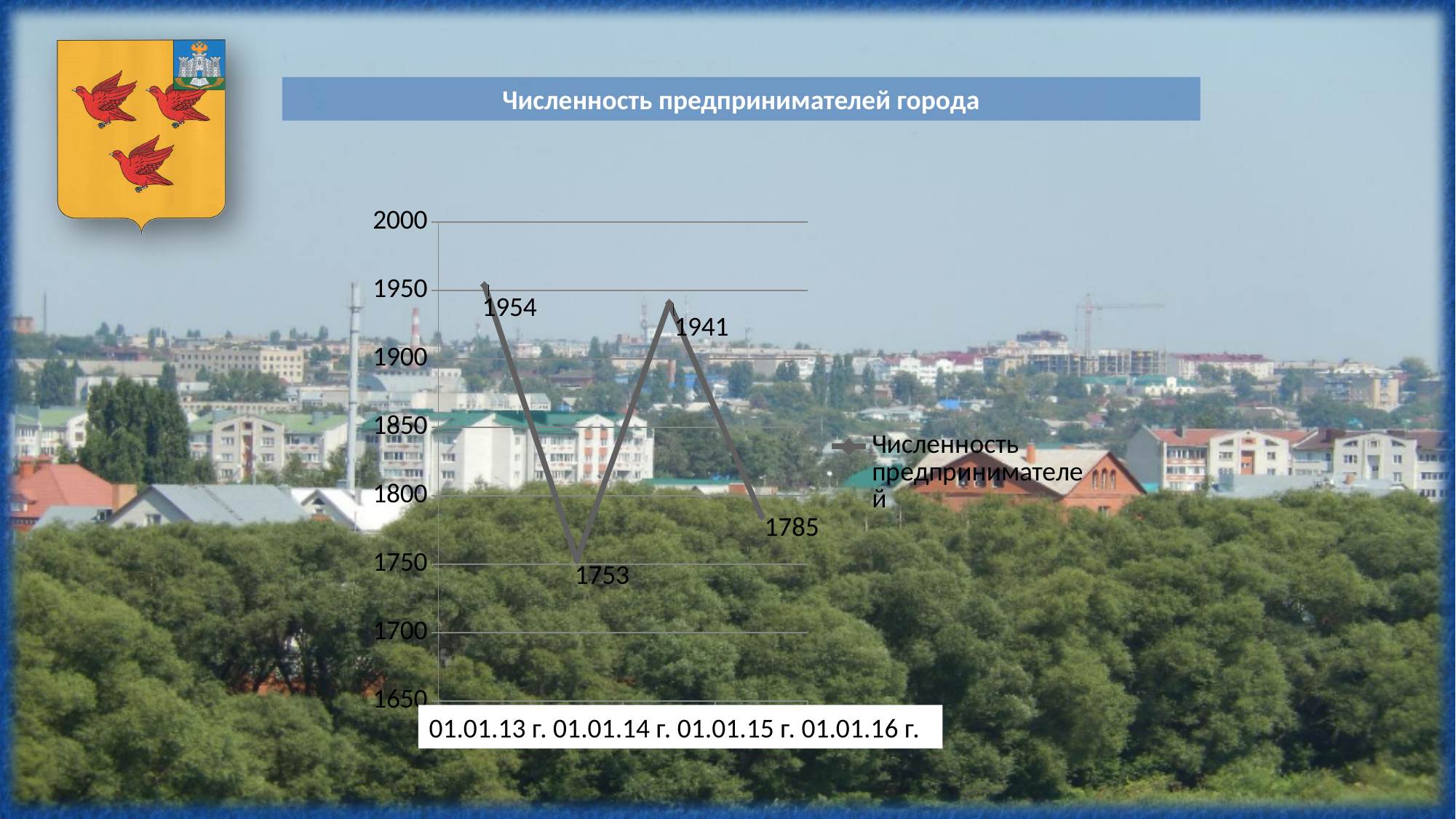
What is the value for 01.01.13 г.? 1954 What is the difference between the values for 01.01.13 г. and 01.01.14 г.? 201 What is the difference between the values for 01.01.15 г. and 01.01.16 г.? 156 Which date has the lowest value? 01.01.14 г. What kind of chart is shown on the slide? line chart What is the title of the chart? Численность предпринимателей города What is the value for 01.01.16 г.? 1785 What is the value for 01.01.14 г.? 1753 Which is larger, the value for 01.01.14 г. or the value for 01.01.16 г.? 01.01.16 г. How many data points are plotted on the chart? 4 Which date has the highest value? 01.01.13 г. What is the value for 01.01.15 г.? 1941